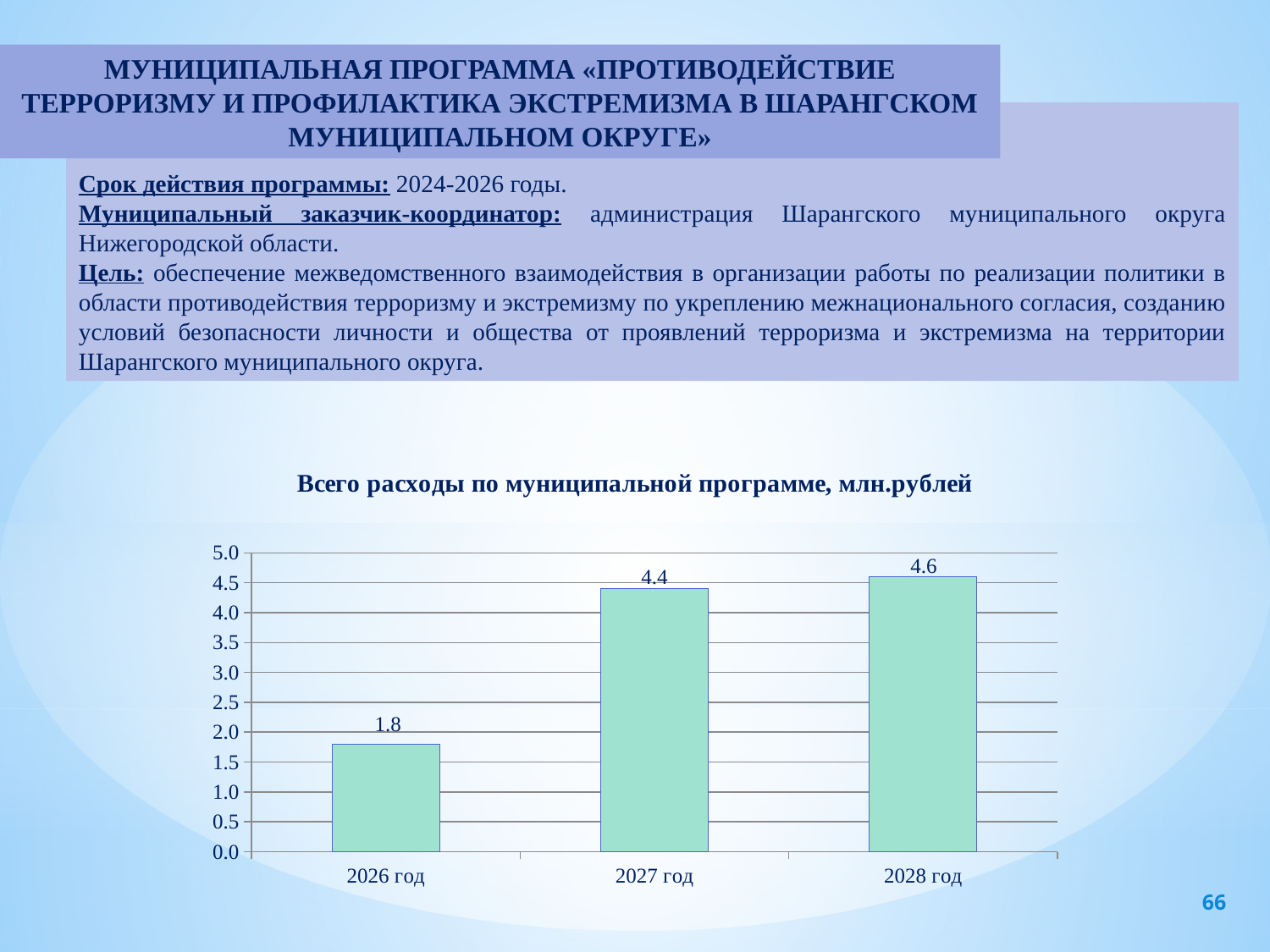
How many years are shown on the chart? 3 Which is larger, the value for 2026 год or the value for 2027 год? 2027 год What is the difference between the values for 2028 год and 2027 год? 0.2 What is the title of the chart? Всего расходы по муниципальной программе, млн.рублей Which year has the lowest value? 2026 год What is the value for 2028 год? 4.6 Which year has the highest value? 2028 год What kind of chart is shown on the slide? bar chart Is the value for 2026 год greater or less than 2.0? less What is the value for 2027 год? 4.4 What is the difference between the values for 2027 год and 2026 год? 2.6 What is the value for 2026 год? 1.8